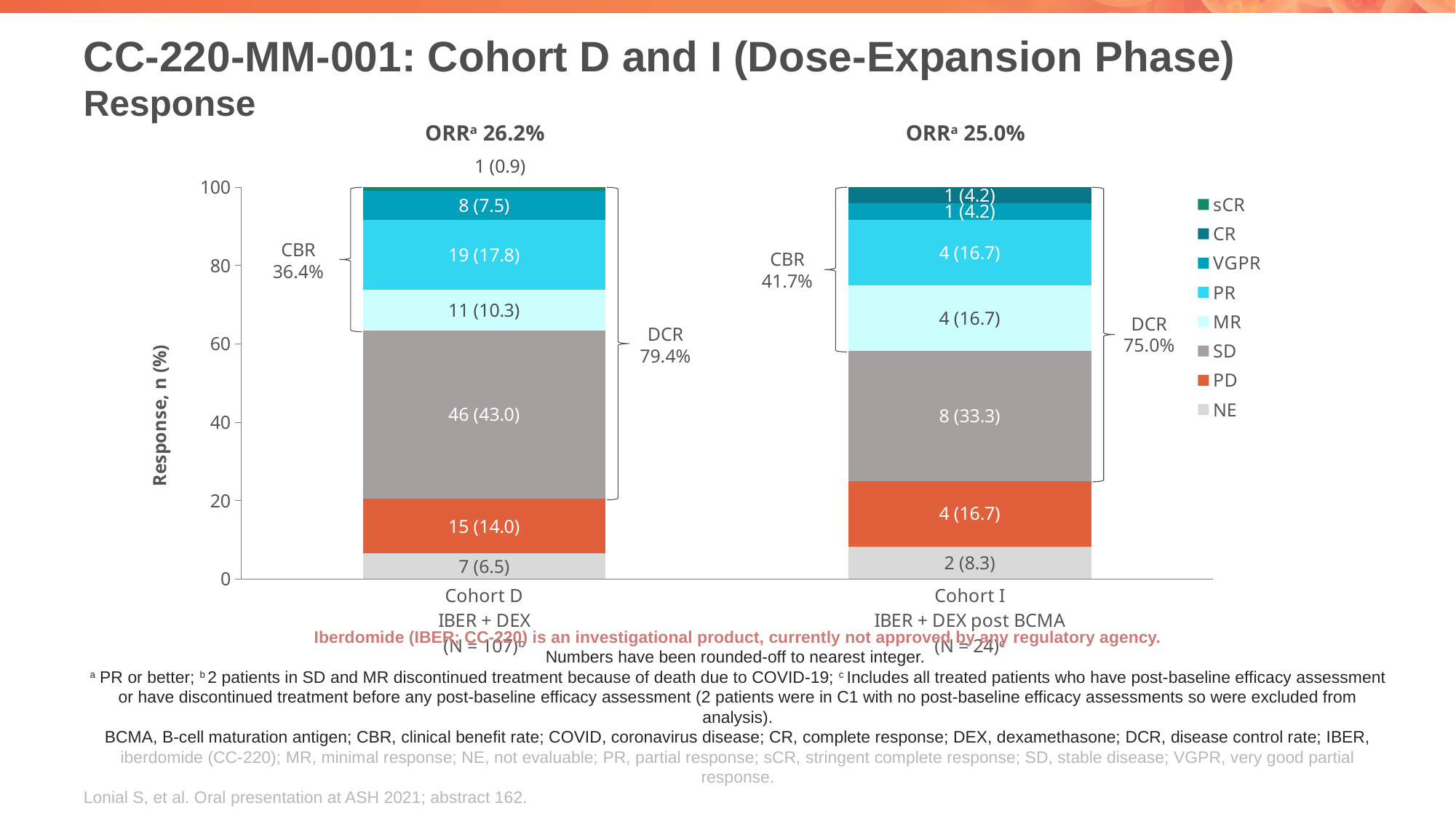
What kind of chart is shown on the slide? Stacked bar chart What DCR is annotated for Cohort I? 75.0% Which response category is the smallest segment in the Cohort D bar? sCR What is the SD value labelled for Cohort D? 46 (43.0) What is the ORR shown above the Cohort D bar? 26.2% Which response category is the largest segment in the Cohort D bar? SD What is the PR value labelled for Cohort I? 4 (16.7) How many cohorts (bars) are plotted in the chart? 2 Which is larger in Cohort I: the SD segment or the PD segment? SD How many series does the legend list? 8 What is the PD value labelled for Cohort D? 15 (14.0) What is the NE value labelled for Cohort I? 2 (8.3)